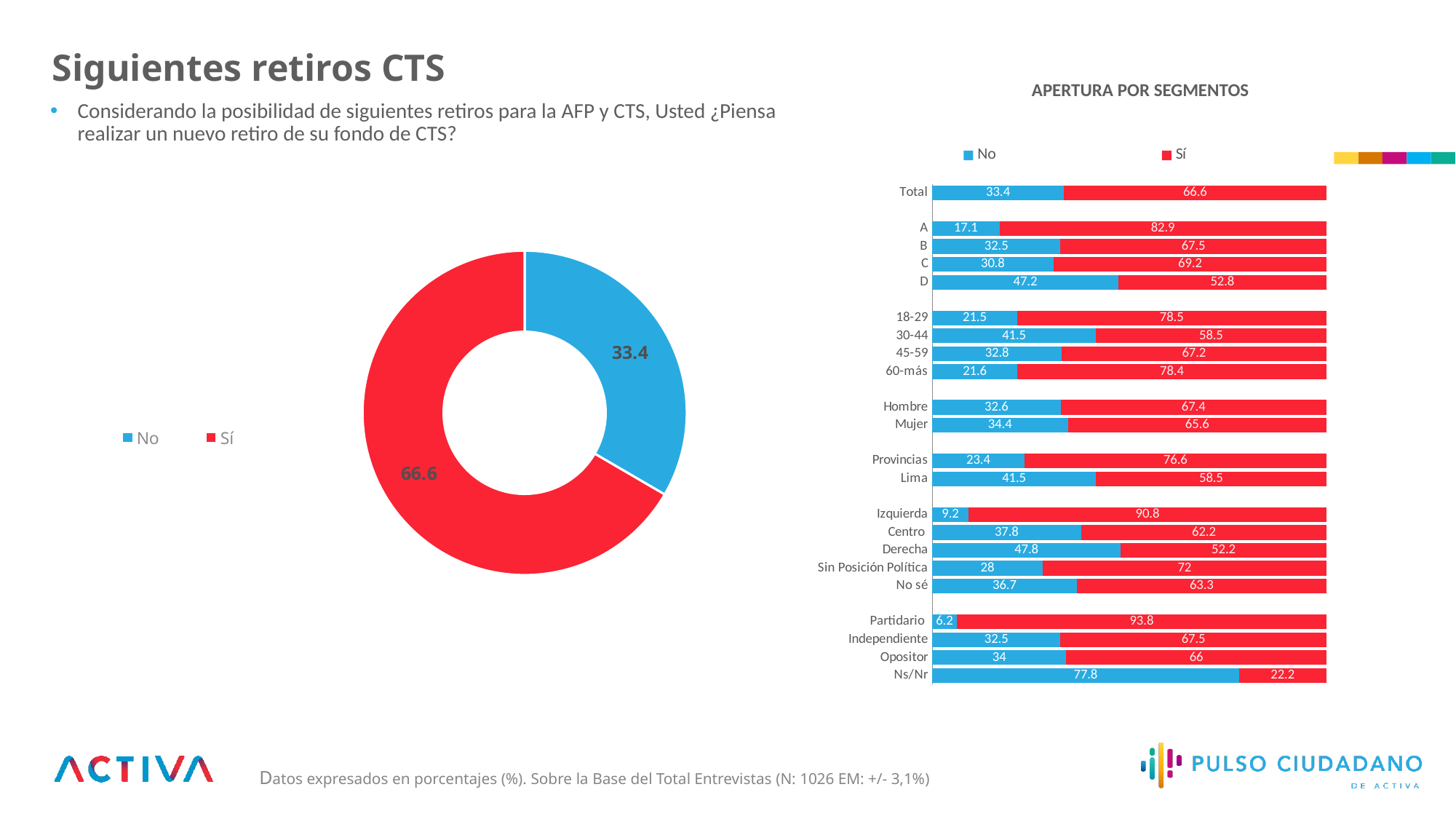
In the "APERTURA POR SEGMENTOS" bar chart, which category has the lowest "No" value? Partidario In the "APERTURA POR SEGMENTOS" bar chart, which is larger, the "No" value for Derecha or for Centro? Derecha In the "APERTURA POR SEGMENTOS" bar chart, what is the difference between the "Sí" values for Provincias and Lima? 18.1 In the "APERTURA POR SEGMENTOS" bar chart, which category has the highest "Sí" value? Partidario How many series does the legend of the "APERTURA POR SEGMENTOS" bar chart list? 2 In the "APERTURA POR SEGMENTOS" bar chart, what is the "Sí" value for Izquierda? 90.8 What kind of chart is the chart on the left of the slide? Donut (pie) chart What kind of chart is the "APERTURA POR SEGMENTOS" chart on the right? Stacked bar chart In the "APERTURA POR SEGMENTOS" bar chart, what is the "No" value for Ns/Nr? 77.8 In the donut chart on the left, what is the value for "Sí"? 66.6 In the donut chart on the left, what is the value for "No"? 33.4 In the donut chart on the left, which slice is larger, "No" or "Sí"? Sí